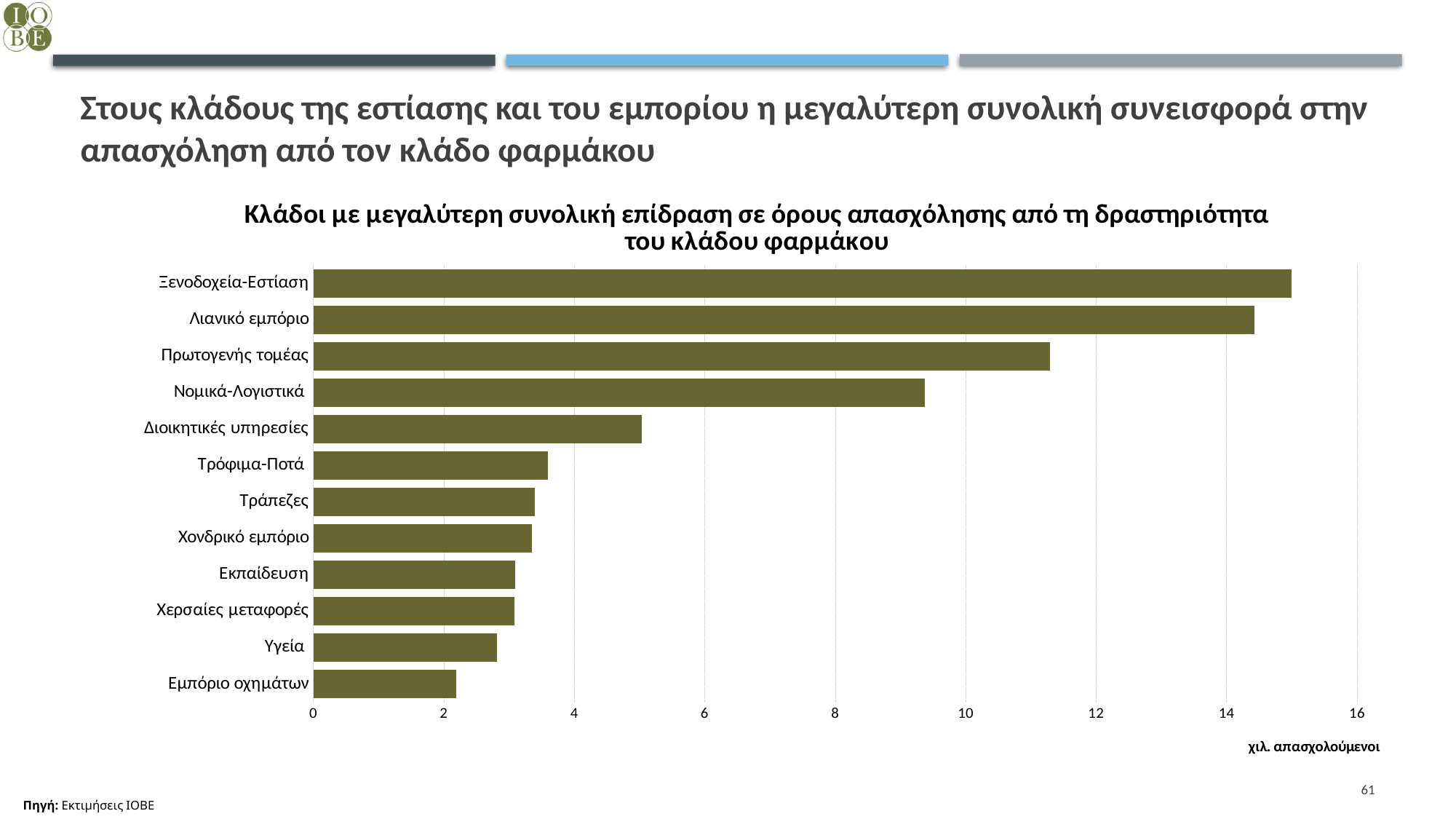
Which sector has the lowest value in the chart? Εμπόριο οχημάτων Is the value for Νομικά-Λογιστικά greater or less than 8? greater Which sector has the highest value in the chart? Ξενοδοχεία-Εστίαση Which is larger, the value for Υγεία or the value for Τρόφιμα-Ποτά? Τρόφιμα-Ποτά Is the value for Πρωτογενής τομέας greater or less than 12? less Is the value for Εμπόριο οχημάτων greater or less than 2? greater What kind of chart is shown on the slide? Bar chart Which is larger, the value for Λιανικό εμπόριο or the value for Πρωτογενής τομέας? Λιανικό εμπόριο What unit is indicated below the x axis of the chart? χιλ. απασχολούμενοι How many sectors (categories) are plotted in the chart? 12